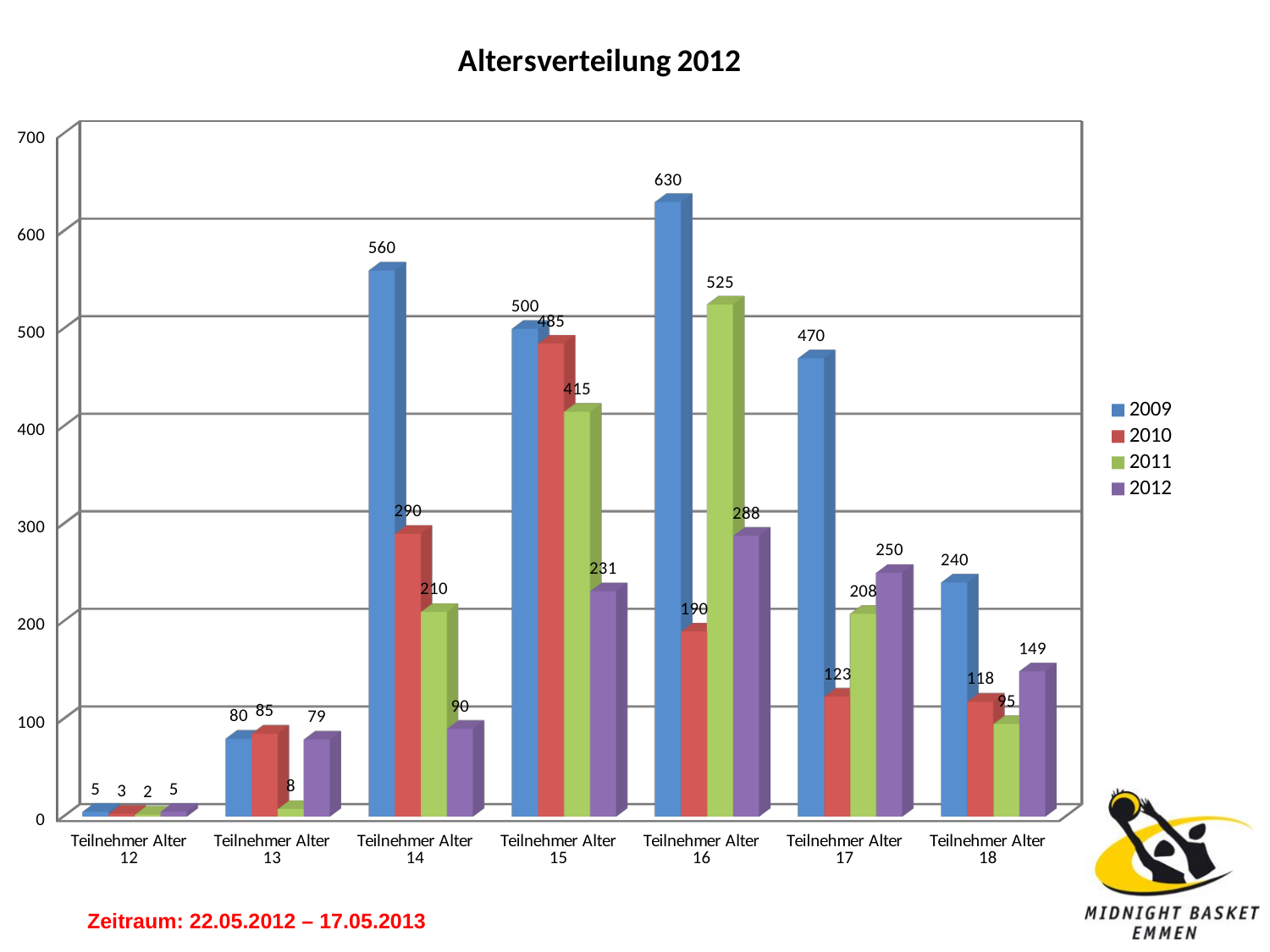
What is the value for 2011 at Teilnehmer Alter 14? 210 What is the difference between the 2009 and 2010 values at Teilnehmer Alter 14? 270 How many age categories are shown on the x axis? 7 What is the value for 2009 at Teilnehmer Alter 16? 630 What is the value for 2010 at Teilnehmer Alter 15? 485 What kind of chart is shown on the slide? Bar chart Which category has the highest value for the 2011 series? Teilnehmer Alter 16 How many series does the legend list? 4 What is the value for 2012 at Teilnehmer Alter 17? 250 Which category has the lowest value for the 2012 series? Teilnehmer Alter 12 What is the title of the chart? Altersverteilung 2012 Which is larger at Teilnehmer Alter 17: the 2011 value or the 2012 value? 2012